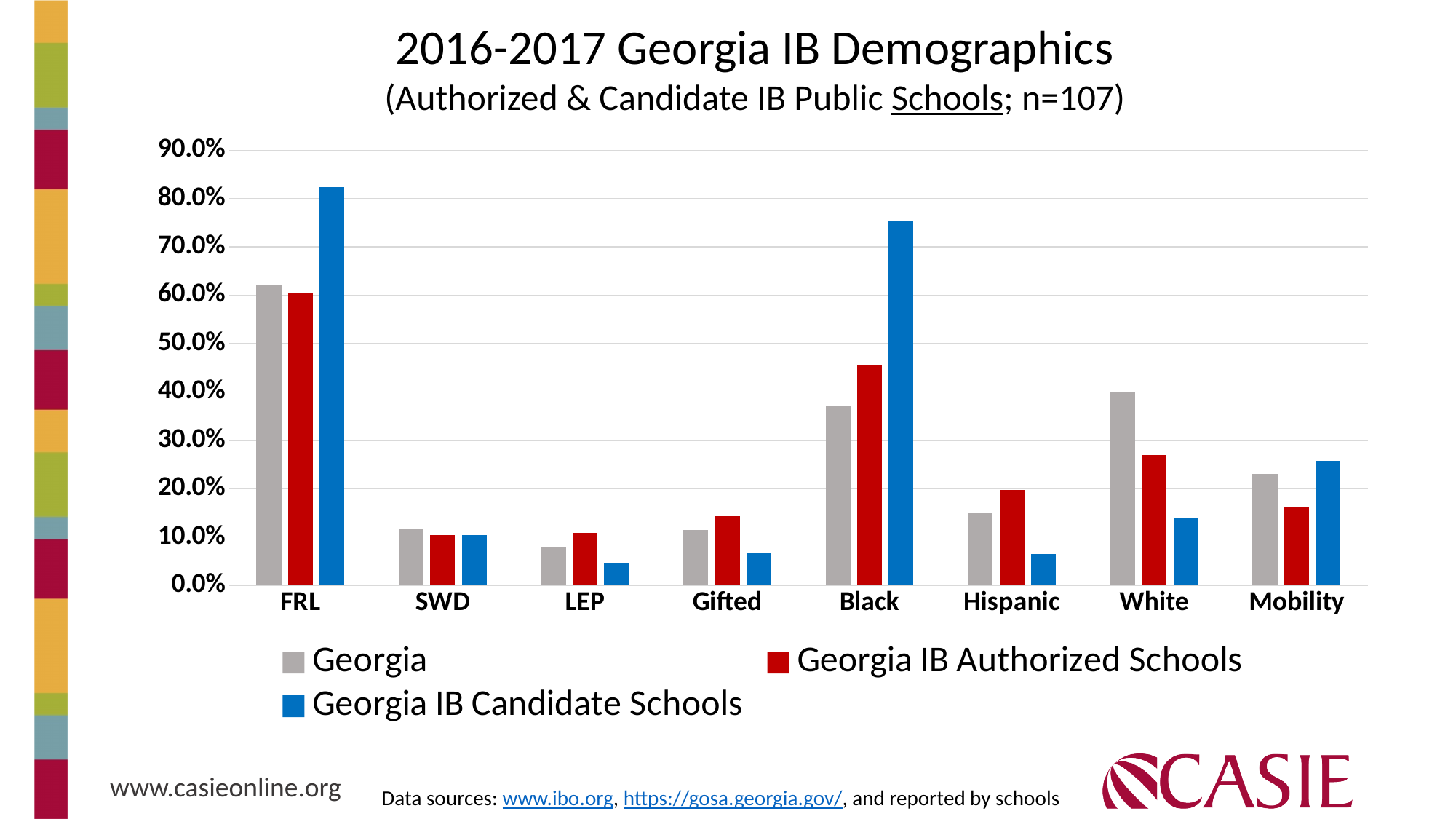
Is the value for Georgia IB Candidate Schools in the FRL category greater or less than 70.0%? greater In the White category, which is larger: the value for Georgia or the value for Georgia IB Candidate Schools? Georgia Which category has the highest value for the Georgia series? FRL Which category has the highest value for Georgia IB Candidate Schools? FRL Is the value for Georgia IB Candidate Schools in the Black category greater or less than 70.0%? greater Which category has the lowest value for Georgia IB Candidate Schools? LEP Is the value for Georgia IB Candidate Schools in the Hispanic category greater or less than 10.0%? less In the Black category, which is larger: the value for Georgia IB Authorized Schools or the value for Georgia IB Candidate Schools? Georgia IB Candidate Schools How many series does the legend list? 3 How many categories are shown along the x axis? 8 What kind of chart is shown on the slide? bar chart